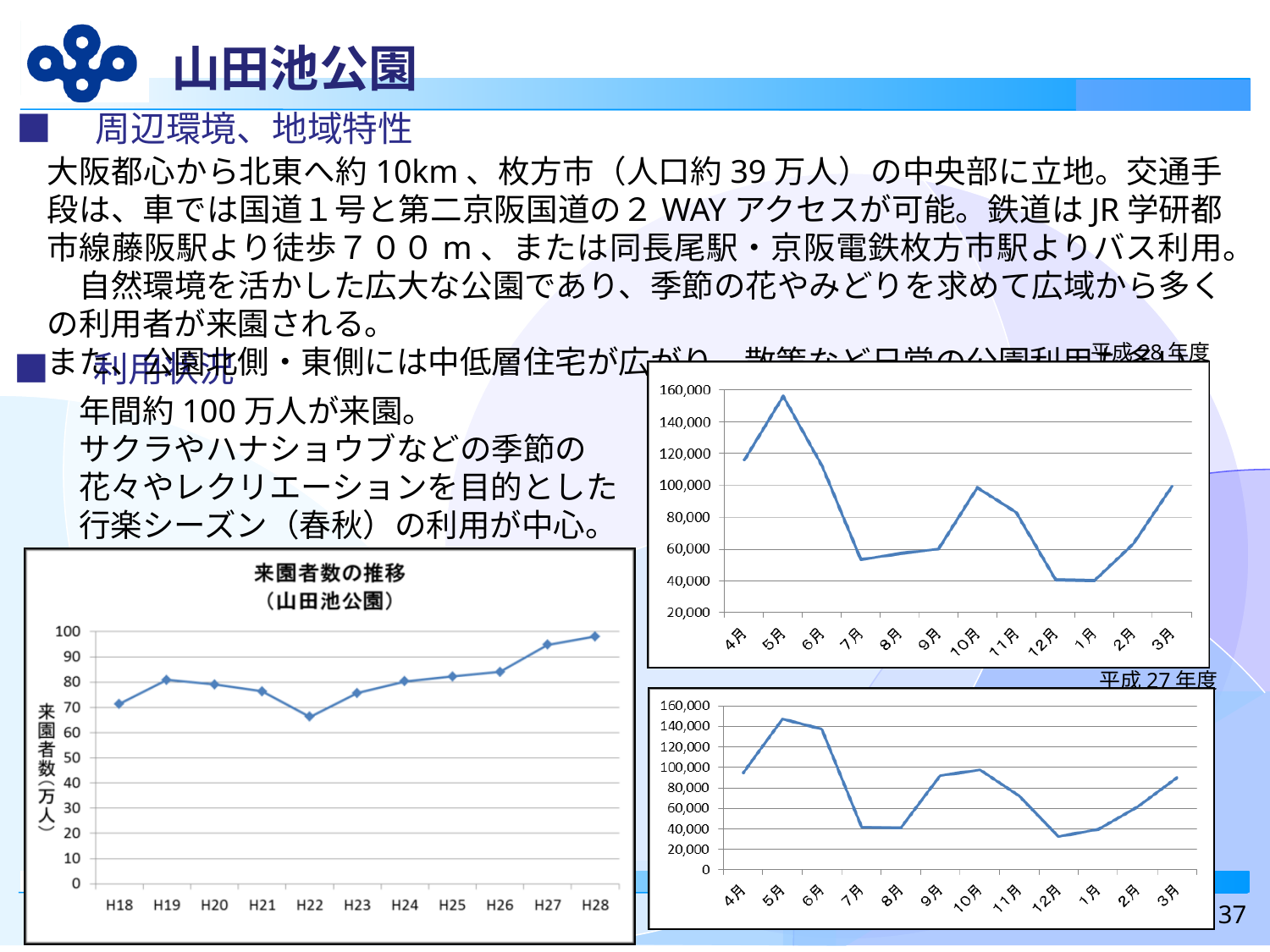
In the chart titled 来園者数の推移（山田池公園）, which year has the highest number of visitors? H28 In the 平成28年度 chart at the top right, is the value for 7月 greater or less than 60,000? less How many months are plotted in the 平成27年度 chart at the bottom right? 12 How many years are plotted in the chart titled 来園者数の推移（山田池公園）? 11 In the 平成27年度 chart at the bottom right, which month has the lowest value? 12月 In the 平成28年度 chart at the top right, which is larger, the value for 5月 or the value for 6月? 5月 In the 平成28年度 chart at the top right, which month has the highest value? 5月 In the chart titled 来園者数の推移（山田池公園）, which year has the lowest number of visitors? H22 In the chart titled 来園者数の推移（山田池公園）, is the value for H22 greater or less than 70? less In the chart titled 来園者数の推移（山田池公園）, is the value for H27 greater or less than 90? greater In the chart titled 来園者数の推移（山田池公園）, do the values overall rise or fall from H18 to H28? rise What kind of chart is the chart titled 来園者数の推移（山田池公園） on the left of the slide? line chart